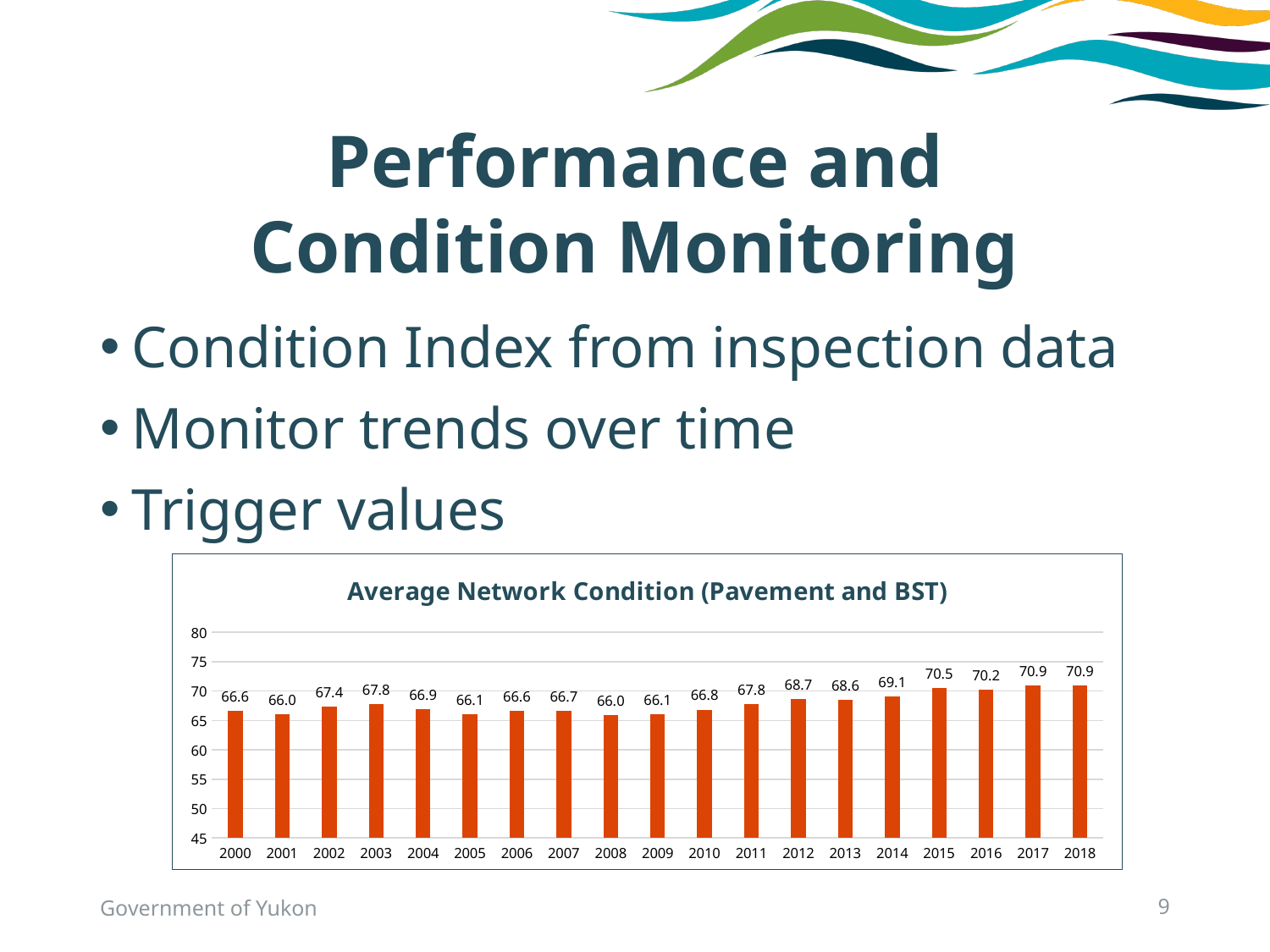
What is the value for 2015 in the Average Network Condition chart? 70.5 What is the highest value shown in the Average Network Condition chart? 70.9 What kind of chart is the Average Network Condition chart? Bar chart What is the value for 2012 in the Average Network Condition chart? 68.7 How many years are shown in the Average Network Condition chart? 19 What is the lowest value shown in the Average Network Condition chart? 66.0 Do the values in the Average Network Condition chart generally rise or fall from 2009 to 2018? Rise What is the difference between the values for 2014 and 2013 in the Average Network Condition chart? 0.5 Is the value for 2016 in the Average Network Condition chart greater or less than 70? greater Which year has the larger value in the Average Network Condition chart, 2003 or 2008? 2003 What is the value for 2000 in the Average Network Condition chart? 66.6 What is the difference between the values for 2018 and 2000 in the Average Network Condition chart? 4.3